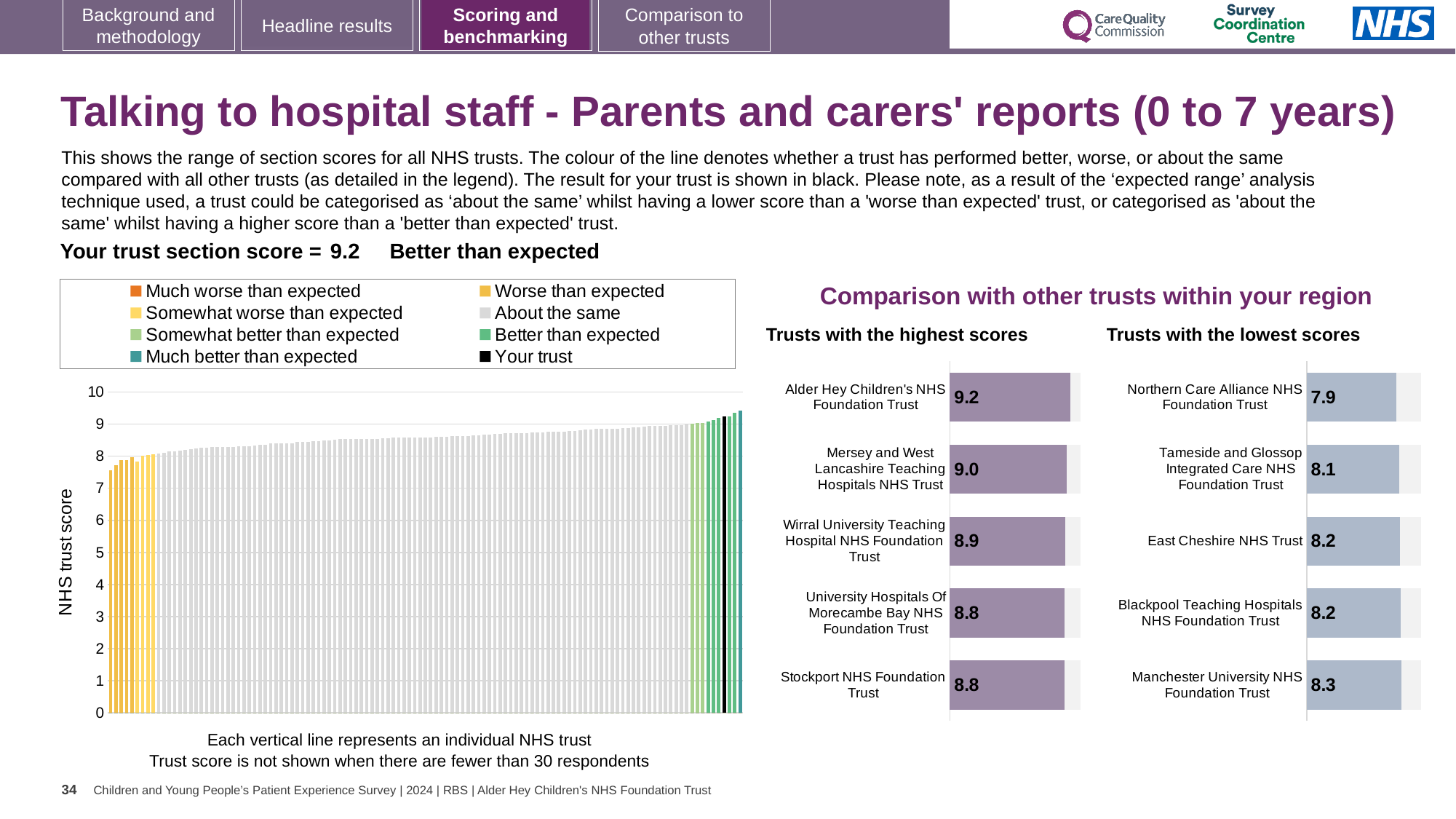
How many trusts are shown in the 'Trusts with the highest scores' chart? 5 In the 'Trusts with the lowest scores' chart, which trust has the lowest score? Northern Care Alliance NHS Foundation Trust In the 'Trusts with the highest scores' chart, what is the difference between the scores of Alder Hey Children's NHS Foundation Trust and Stockport NHS Foundation Trust? 0.4 In the 'Trusts with the lowest scores' chart, which has the higher score: Tameside and Glossop Integrated Care NHS Foundation Trust or East Cheshire NHS Trust? East Cheshire NHS Trust In the 'Trusts with the lowest scores' chart, what is the score for Northern Care Alliance NHS Foundation Trust? 7.9 What kind of chart is the main chart showing NHS trust scores on the left of the slide? Bar chart In the main NHS trust score chart on the left, is the value for the black 'Your trust' bar greater or less than 9? greater In the 'Trusts with the highest scores' chart, what is the score for Wirral University Teaching Hospital NHS Foundation Trust? 8.9 In the 'Trusts with the lowest scores' chart, what is the score for Manchester University NHS Foundation Trust? 8.3 In the 'Trusts with the highest scores' chart, what is the score for Alder Hey Children's NHS Foundation Trust? 9.2 How many entries does the legend of the main NHS trust score chart list? 8 In the 'Trusts with the highest scores' chart, which trust has the highest score? Alder Hey Children's NHS Foundation Trust